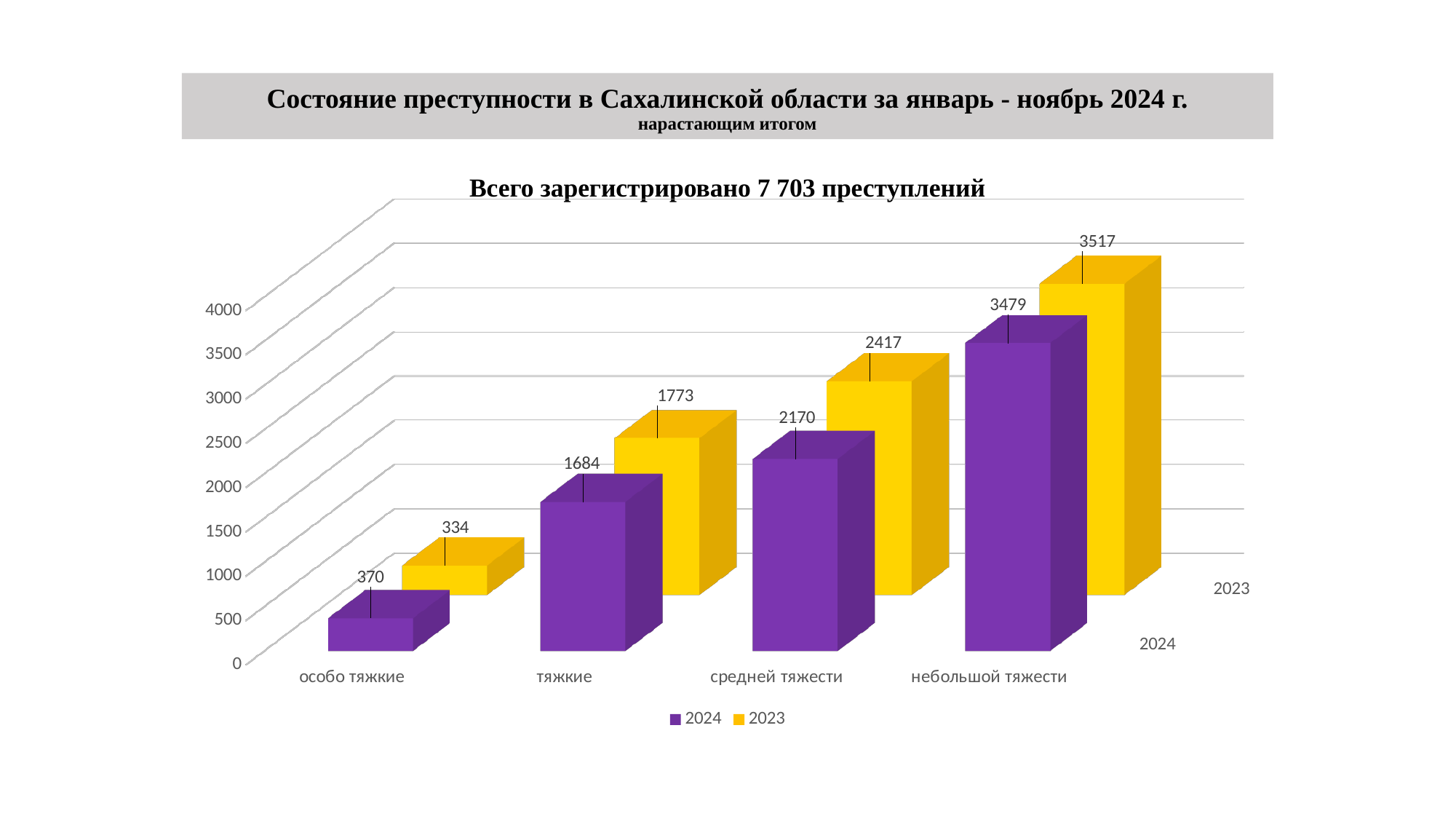
What is the value for "тяжкие" in the 2023 series? 1773 What is the difference between the 2023 and 2024 values for "средней тяжести"? 247 What kind of chart is shown on the slide? bar chart Which category has the lowest value in the 2023 series? особо тяжкие How many series does the legend list? 2 How many categories are shown on the x axis? 4 What is the value for "особо тяжкие" in the 2024 series? 370 What is the value for "средней тяжести" in the 2024 series? 2170 What is the value for "небольшой тяжести" in the 2023 series? 3517 For "особо тяжкие", which series has the larger value, 2024 or 2023? 2024 Which category has the highest value in the 2024 series? небольшой тяжести What is the chart's title? Всего зарегистрировано 7 703 преступлений